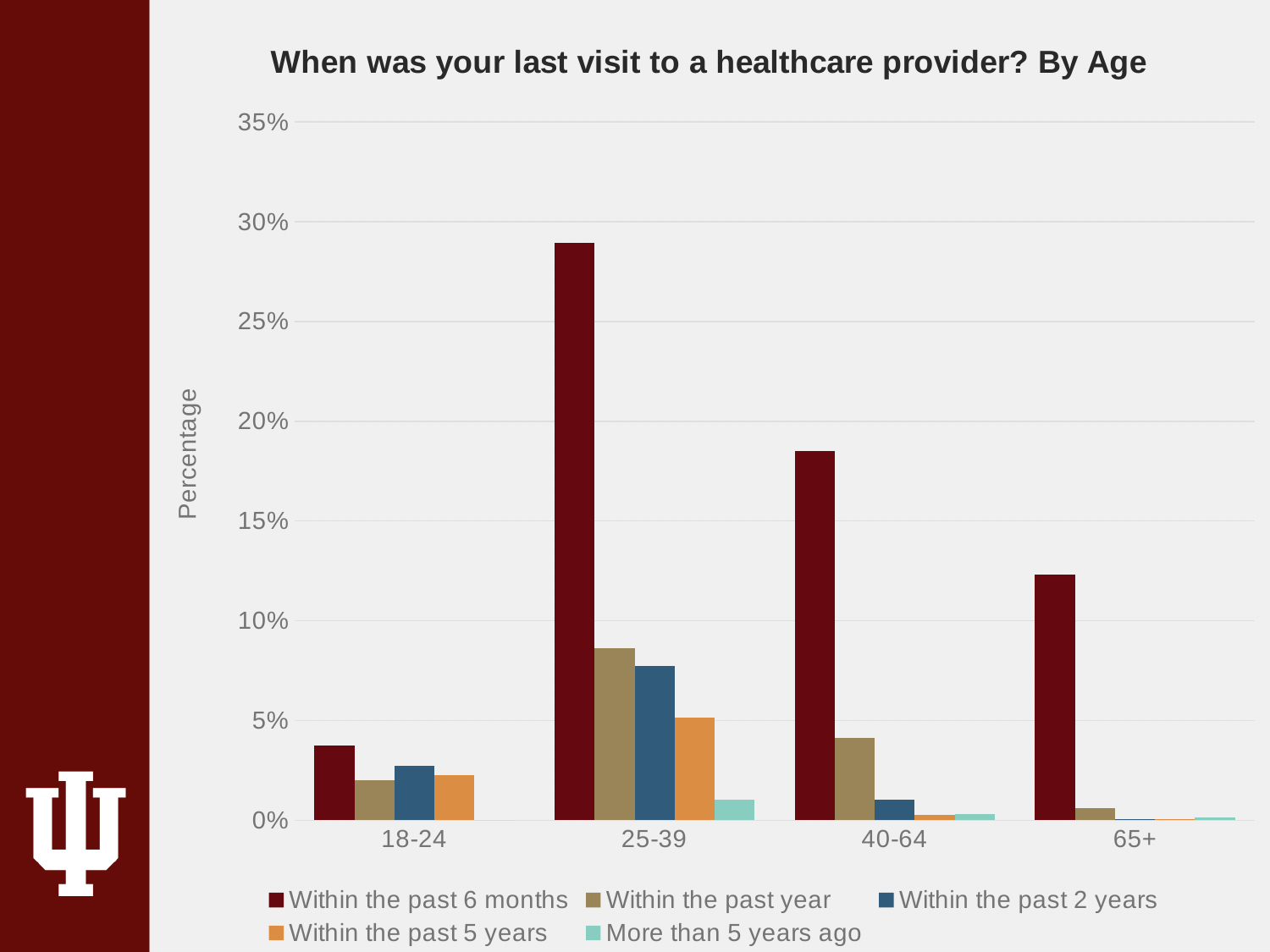
Is the value for "Within the past 6 months" in the 40-64 age group greater or less than 20%? less What is the title of the chart? When was your last visit to a healthcare provider? By Age What kind of chart is shown on the slide? bar chart Which age group has the lowest value for "Within the past 6 months"? 18-24 In the 18-24 age group, which is larger: "Within the past 6 months" or "Within the past year"? Within the past 6 months Is the value for "Within the past 6 months" in the 65+ age group greater or less than 10%? greater Is the value for "Within the past 6 months" in the 25-39 age group greater or less than 25%? greater Which is larger: "Within the past year" for 25-39 or "Within the past year" for 40-64? 25-39 Which age group has the highest value for "Within the past 6 months"? 25-39 What is the title of the y axis? Percentage How many age groups are shown on the x axis? 4 How many series does the legend list? 5